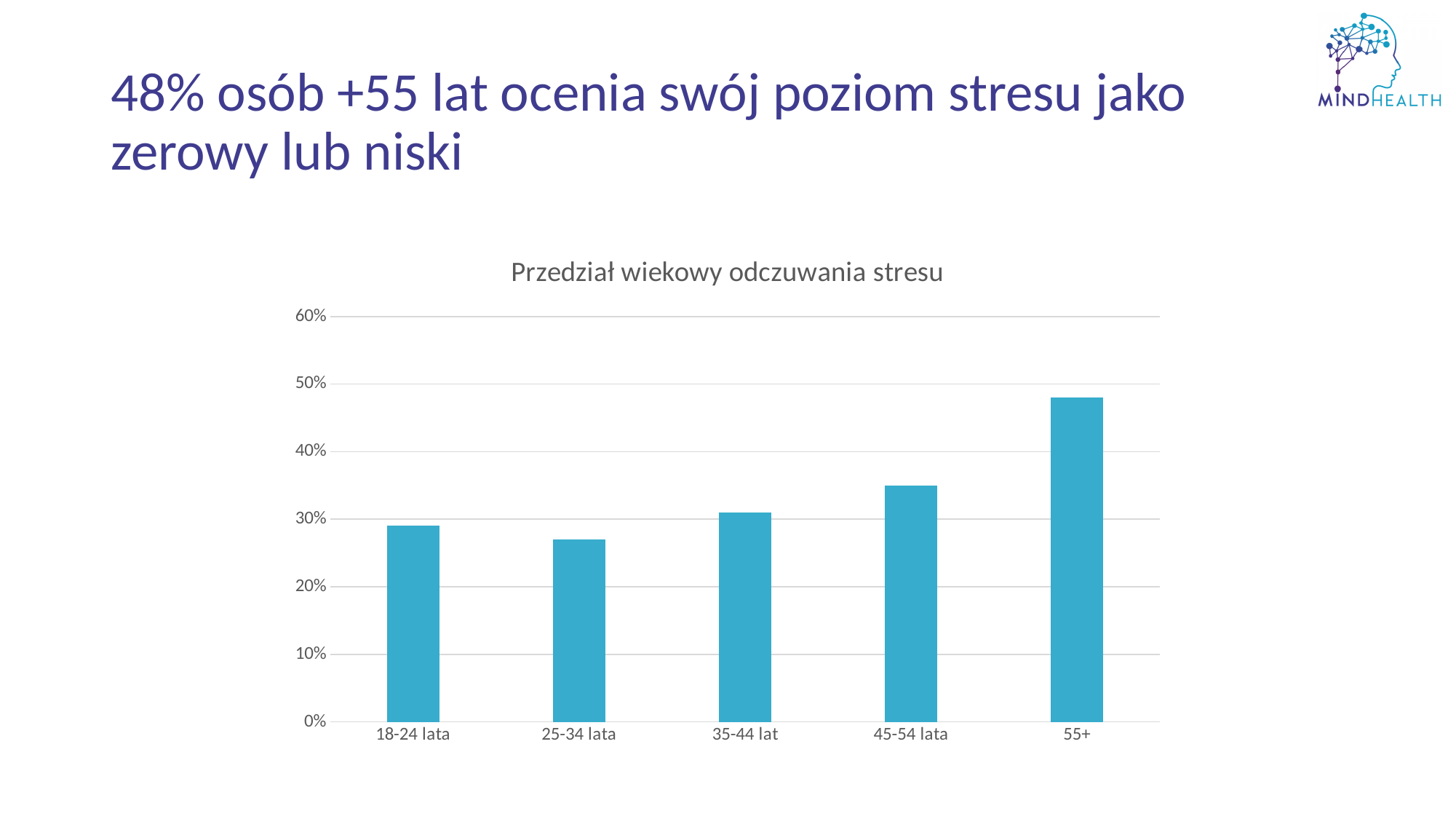
What is the title of the chart? Przedział wiekowy odczuwania stresu From the 25-34 lata group onward, do the values rise or fall along the x axis? rise How many age categories are shown on the x axis of the chart? 5 Is the value for 55+ greater or less than 40%? greater Which age group has the lowest value in the chart? 25-34 lata Is the value for 25-34 lata greater or less than 30%? less Which age group has the highest value in the chart? 55+ What kind of chart is shown on the slide? bar chart Which has the larger value, 45-54 lata or 35-44 lat? 45-54 lata Is the value for 45-54 lata greater or less than 30%? greater What is the value for the 55+ age group? 48%